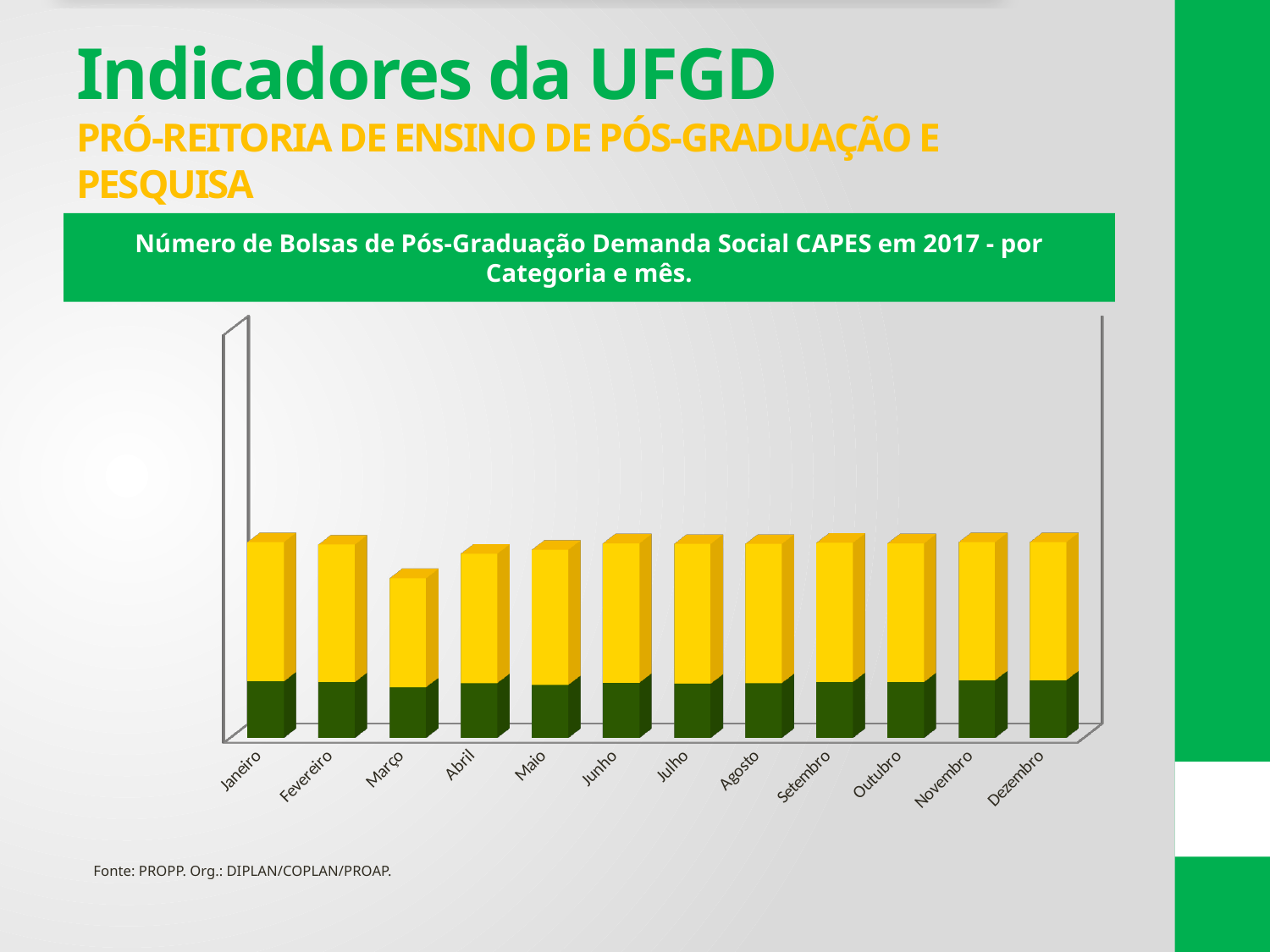
Which month has the lowest total bar in the chart? Março Which bar is taller, Março or Abril? Abril What kind of chart is shown on the slide? bar chart What is the first category on the x axis of the chart? Janeiro What is the last category on the x axis of the chart? Dezembro Which bar is taller, Janeiro or Março? Janeiro What is the title of the chart? Número de Bolsas de Pós-Graduação Demanda Social CAPES em 2017 - por Categoria e mês. Which month has the shortest yellow segment in the chart? Março How many months (categories) are shown on the x axis of the chart? 12 What two colours are used for the stacked segments of the bars? yellow and dark green